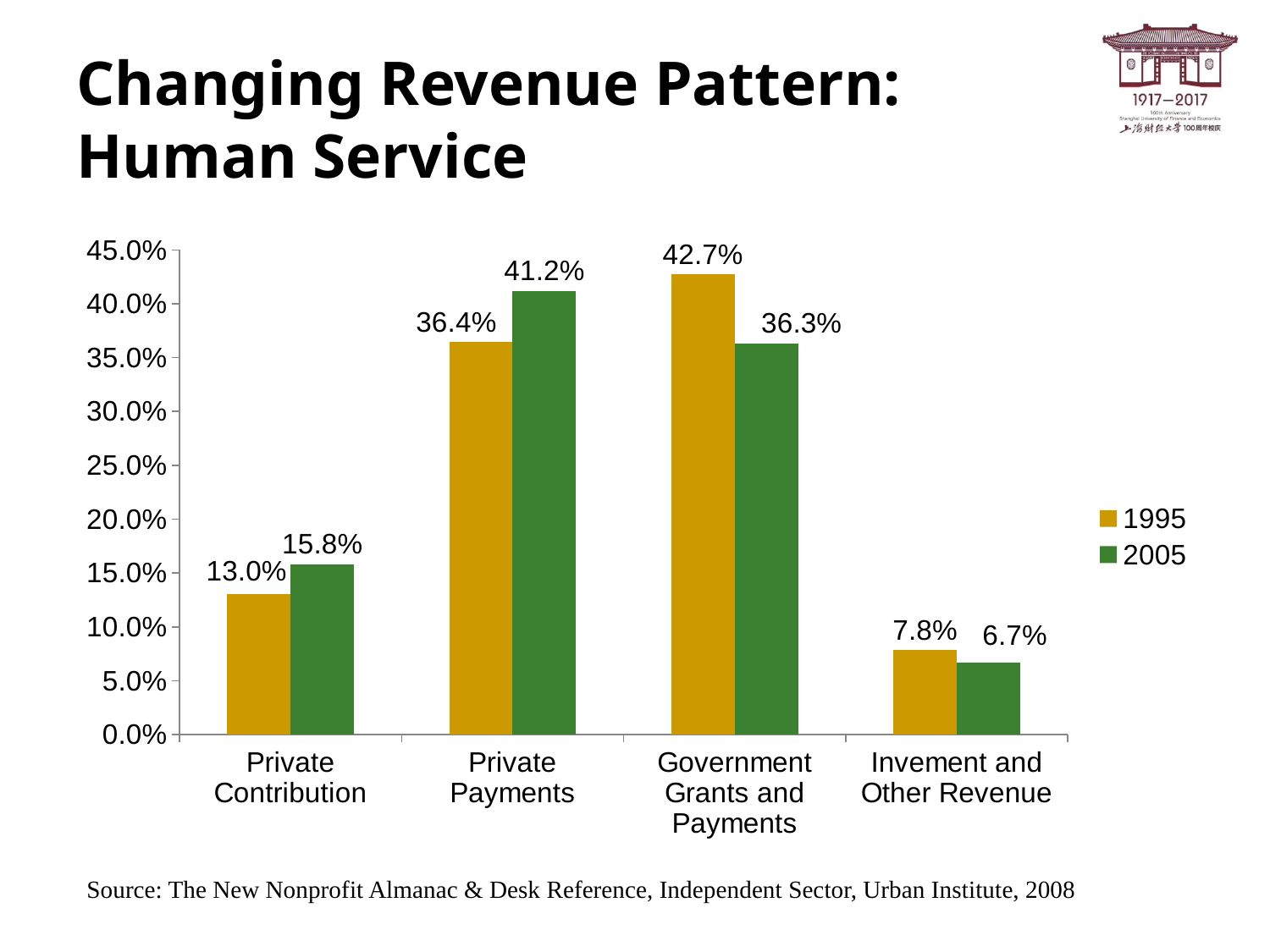
Which category has the lowest 2005 value? Invement and Other Revenue What kind of chart is shown on the slide? Bar chart What is the 2005 value for Government Grants and Payments? 36.3% How many categories are shown on the x axis? 4 What is the 1995 value for Invement and Other Revenue? 7.8% Which is larger for Private Contribution, the 1995 value or the 2005 value? 2005 What is the difference between the 2005 and 1995 values for Private Payments? 4.8% What is the 2005 value for Private Payments? 41.2% Which category has the highest 1995 value? Government Grants and Payments What is the 1995 value for Private Contribution? 13.0% How many series does the legend list? 2 What is the difference between the 1995 and 2005 values for Government Grants and Payments? 6.4%